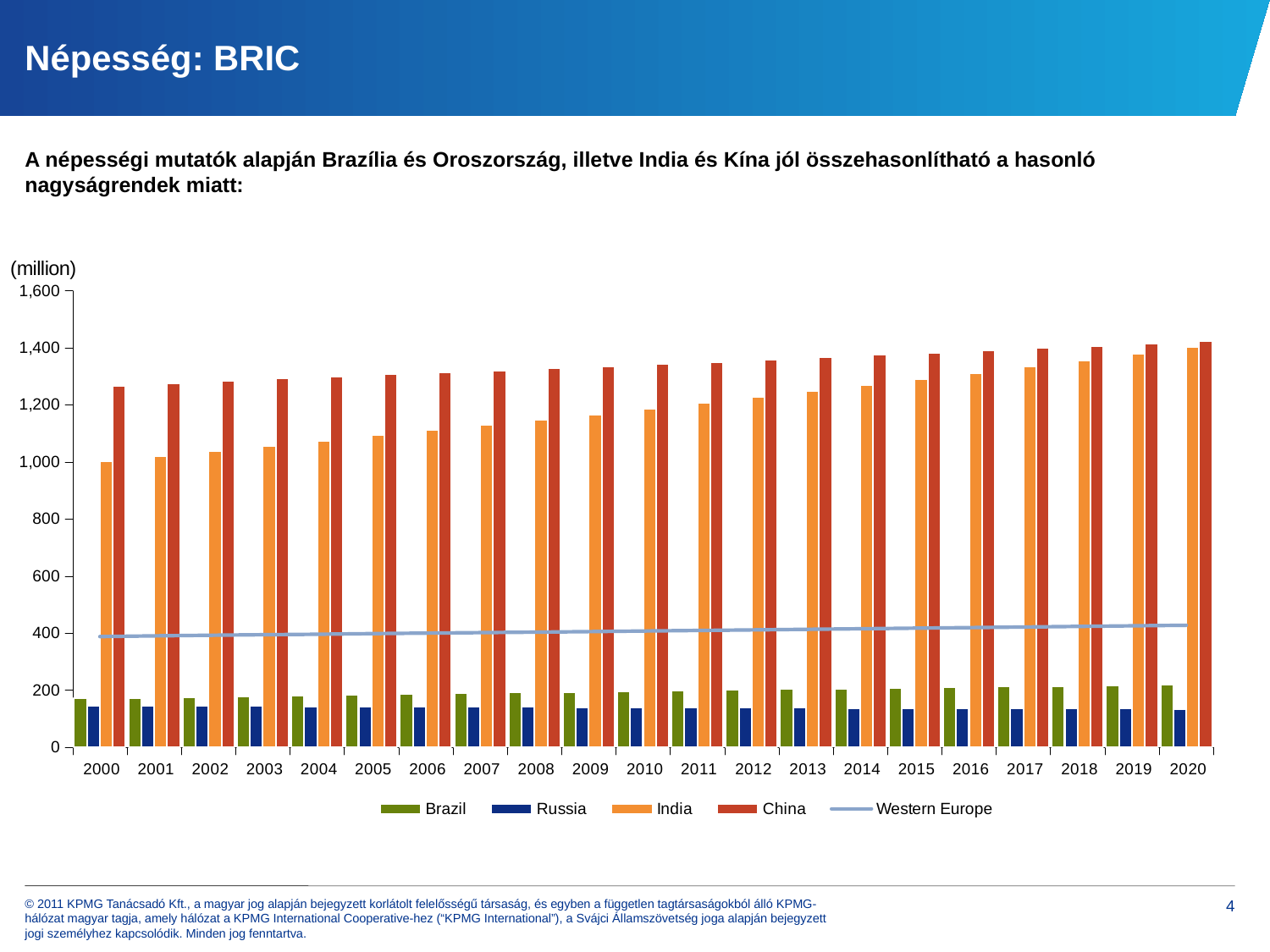
Is the value for China in 2000 greater or less than 1,200? greater What unit is indicated above the y axis? (million) How many years are shown along the x axis? 21 In 2000, which is larger, the value for China or the value for India? China Is the value for Russia in 2010 greater or less than 200? less What kind of chart is shown on the slide? bar chart (with a line series for Western Europe) In 2020, which is larger, the value for Brazil or the value for Russia? Brazil Is the value for Brazil in 2000 greater or less than 200? less Do the values for India rise or fall from 2000 to 2020? rise Which series is plotted as a line rather than bars? Western Europe How many series does the legend list? 5